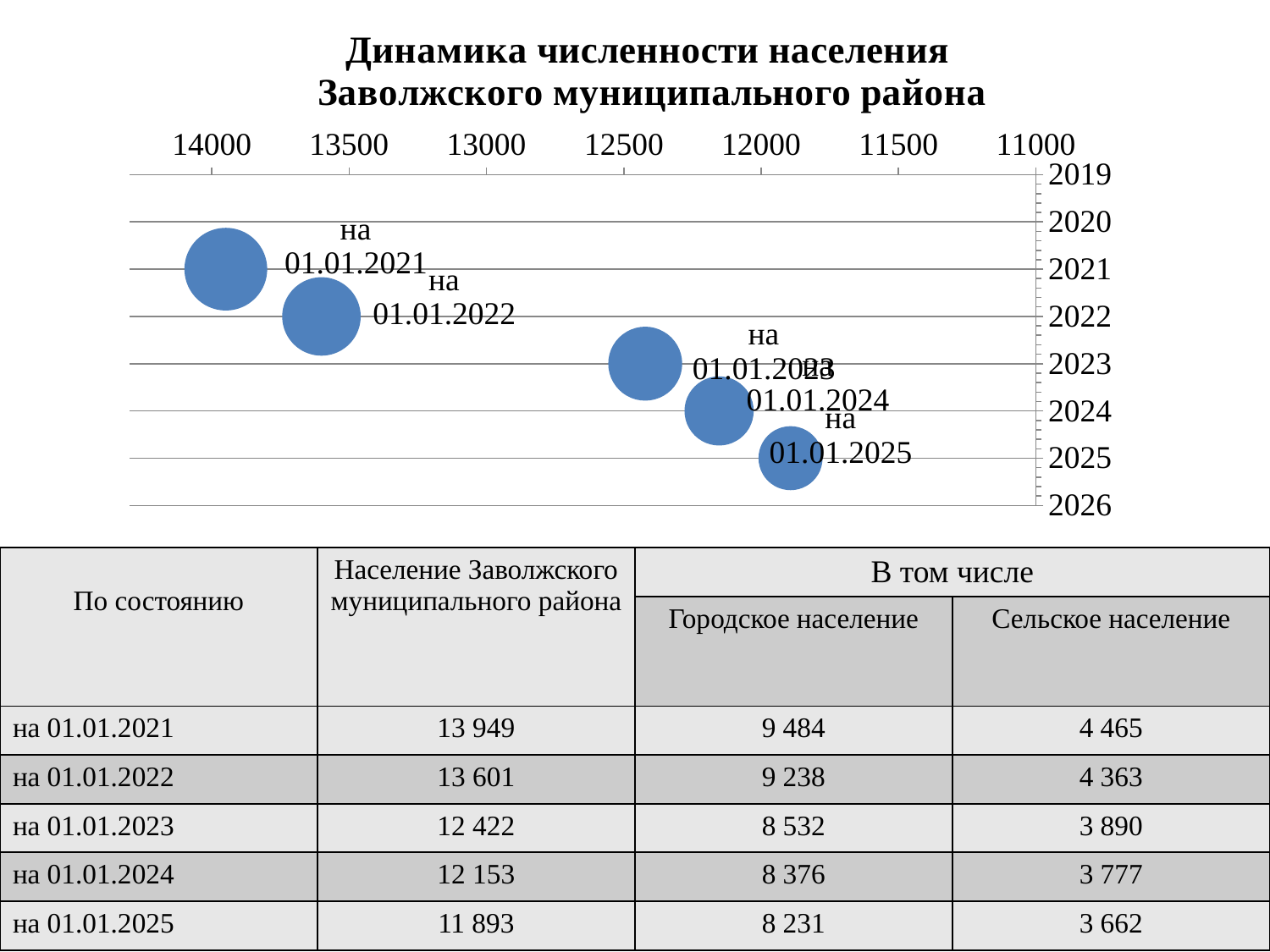
According to the table on the slide, what is the population of the Заволжский municipal district на 01.01.2023? 12 422 How many bubbles (data points) are plotted on the chart? 5 According to the table on the slide, what is the difference between the district population на 01.01.2021 and на 01.01.2025? 2 056 Is the value for на 01.01.2021 greater or less than 13500? greater Do the population values rise or fall from 01.01.2021 to 01.01.2025? fall What is the title of the chart? Динамика численности населения Заволжского муниципального района What kind of chart is shown on the slide? bubble chart Is the value for на 01.01.2025 greater or less than 12000? less Which date has the highest population value on the chart? на 01.01.2021 Is the value for на 01.01.2023 greater or less than 12500? less Which date has the lowest population value on the chart? на 01.01.2025 Which is larger, the value for на 01.01.2022 or the value for на 01.01.2024? на 01.01.2022